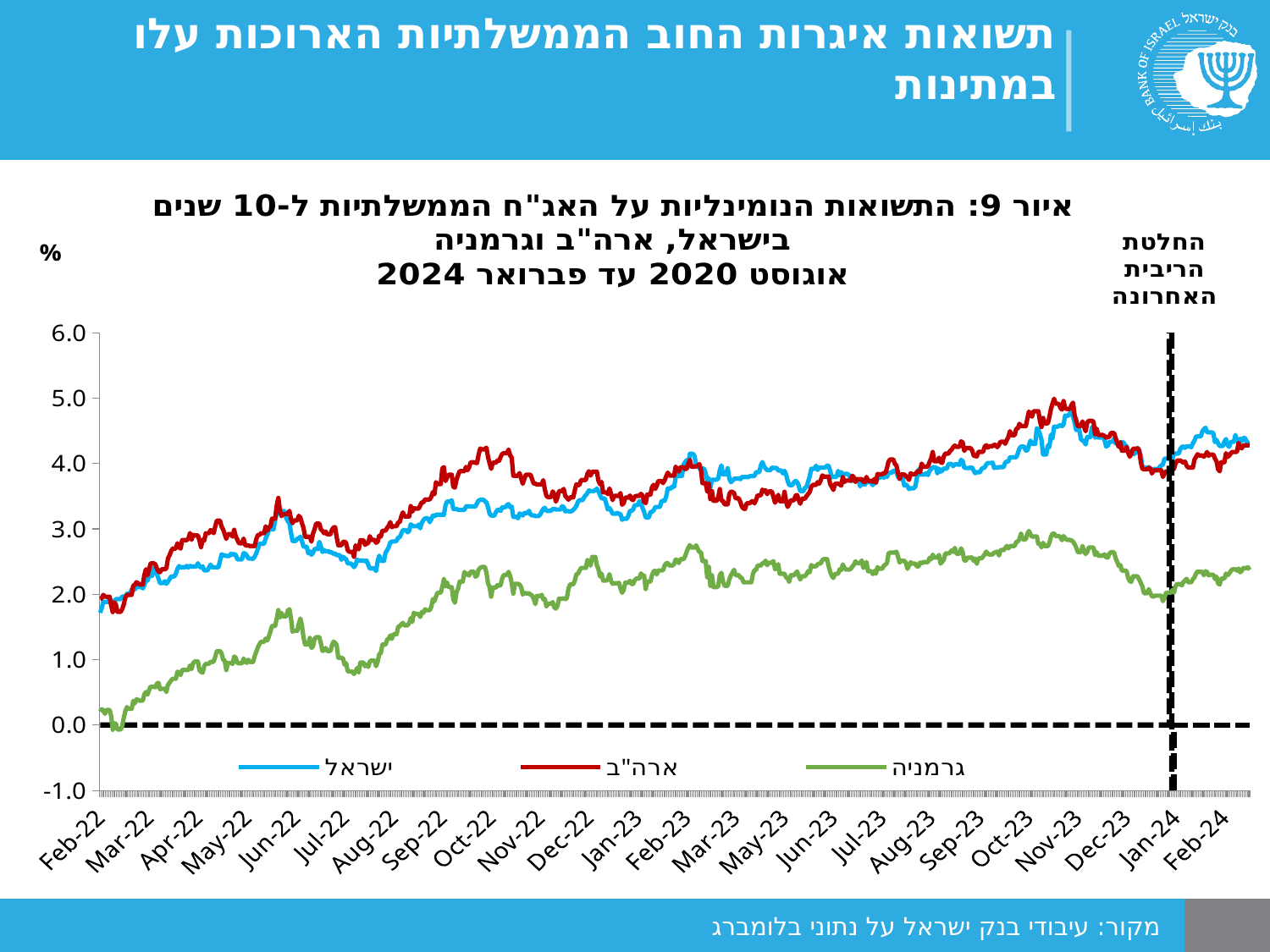
Is the value for ארה"ב at Jul-22 greater or less than 3.0? less Which is larger at Feb-24, the value for ארה"ב or the value for גרמניה? ארה"ב Which series reaches the highest value around Oct-23? ארה"ב How many series does the legend list? 3 Is the value for גרמניה at Feb-24 greater or less than 2.0? greater Does the value for גרמניה rise or fall overall from Feb-22 to Feb-24? rise Which series is the lowest across the whole period? גרמניה What does the dashed vertical line near Jan-24 mark, according to the label on the slide? החלטת הריבית האחרונה Which colour represents ישראל in the chart? blue Is the value for ישראל at Oct-23 greater or less than 4.0? greater What kind of chart is shown on the slide? line chart